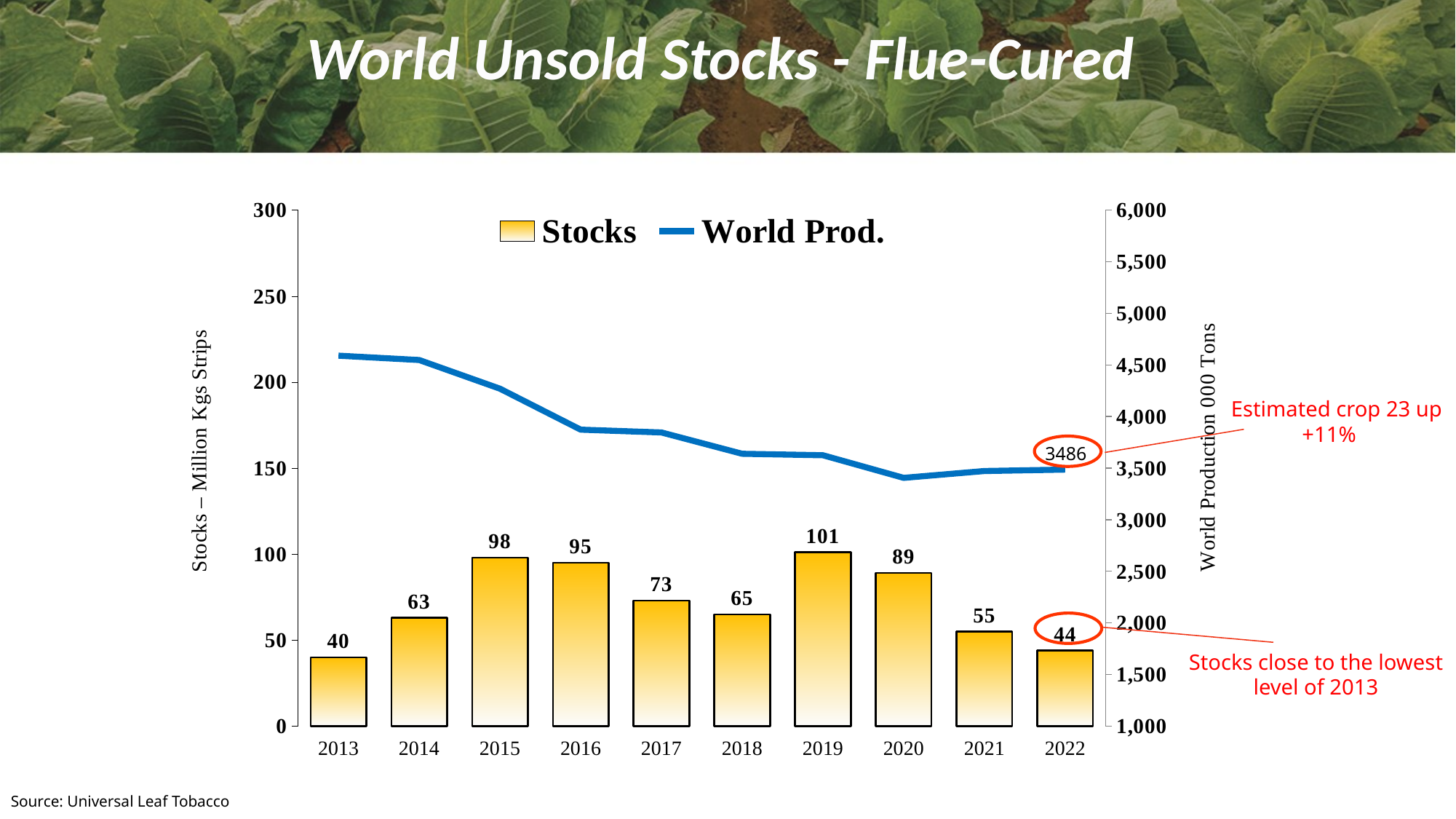
Is the World Prod. value for 2013 greater or less than 4,000? greater Which is larger, the Stocks value for 2015 or for 2016? 2015 Which year has the highest Stocks value? 2019 What is the Stocks value for 2019? 101 What is the label of the right-hand vertical axis? World Production 000 Tons Which year has the lowest Stocks value? 2013 What is the World Prod. value labelled for 2022? 3486 Does the World Prod. line generally rise or fall from 2013 to 2020? fall How many years are shown on the x axis? 10 What is the difference between the Stocks values for 2019 and 2022? 57 How many series does the legend list? 2 What is the Stocks value for 2013? 40